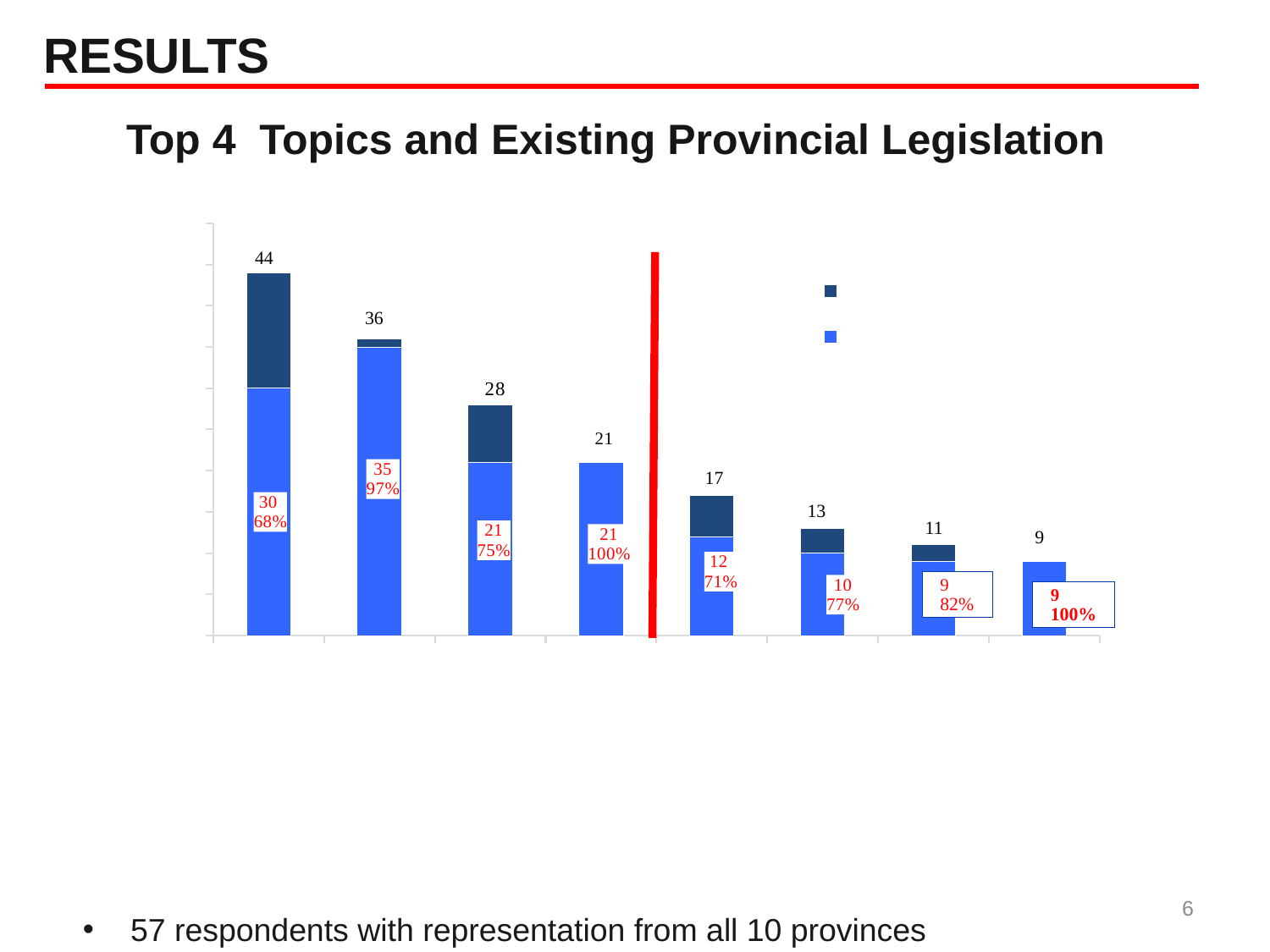
How many bars are plotted in the chart? 8 What is the total value labelled above the tallest bar? 44 What percentage is printed inside the light blue segment of the first bar from the left? 68% Do the bar totals rise or fall moving from left to right across the chart? fall What is the total value labelled above the second bar from the left? 36 What count is printed in red inside the light blue segment of the first bar from the left? 30 What is the total value labelled above the shortest bar (the rightmost bar)? 9 What kind of chart is shown on the slide? bar chart How many series does the legend show? 2 What is the title shown above the chart? Top 4 Topics and Existing Provincial Legislation Which bar has the larger total: the third bar from the left (28) or the fifth bar from the left (17)? the third bar from the left What is the difference between the totals of the first bar (44) and the second bar (36)? 8